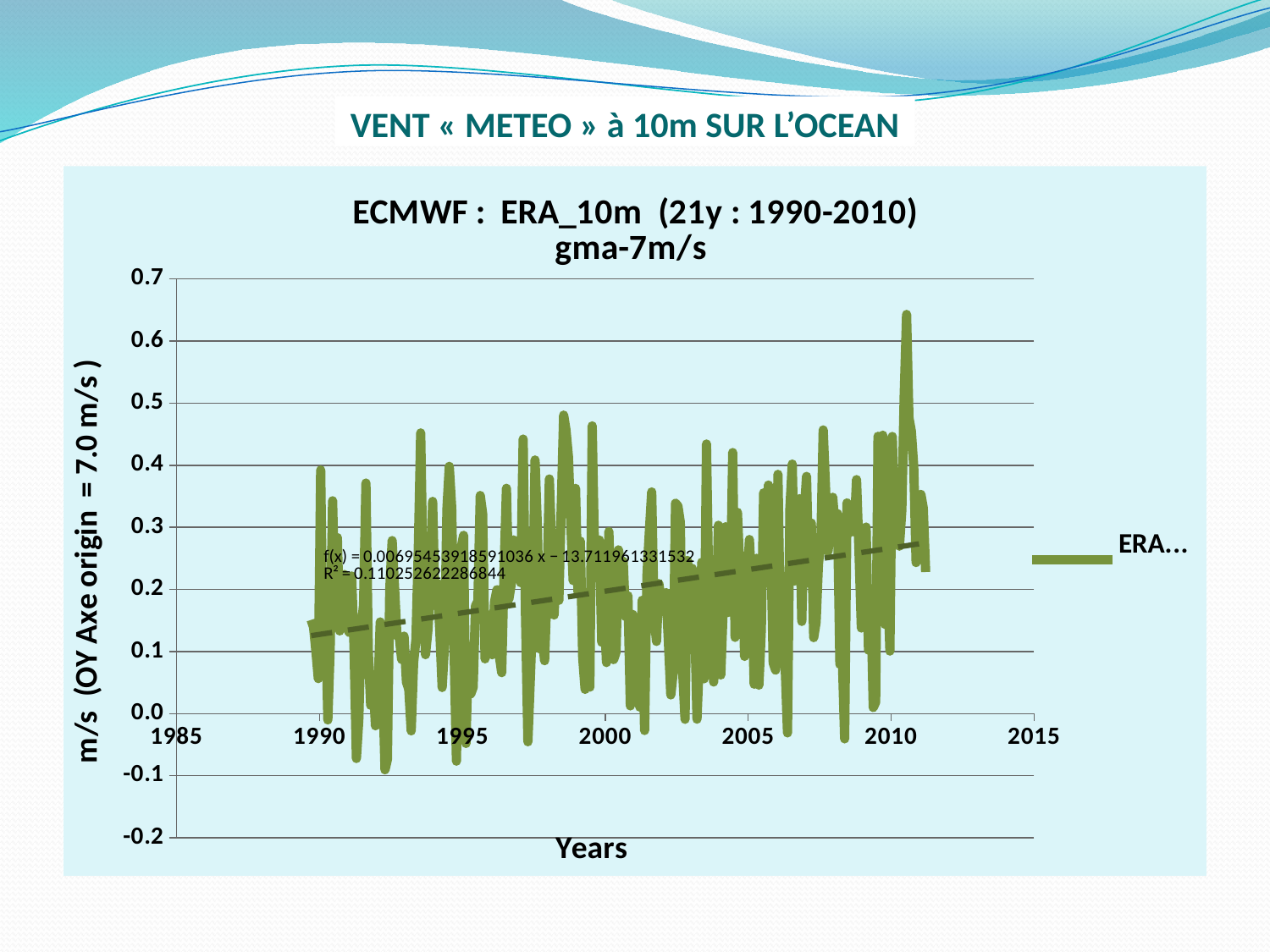
What is the slope coefficient in the trend line equation f(x) printed on the chart? 0.00695453918591036 What is the label of the x axis? Years Is the highest peak of the series, near 2010, greater or less than 0.6? greater Is the lowest dip of the series, near 1992, greater or less than 0.0? less What is the highest tick value shown on the y axis? 0.7 How many series does the legend list? 1 What kind of chart is shown on the slide? line chart What is the lowest tick value shown on the y axis? -0.2 What is the intercept in the trend line equation f(x) printed on the chart? −13.711961331532 What is the title of the chart? ECMWF : ERA_10m (21y : 1990-2010) gma-7m/s What is the R² value printed on the chart for the trend line? 0.110252622286844 Does the dashed trend line rise or fall from 1990 to 2010? rise